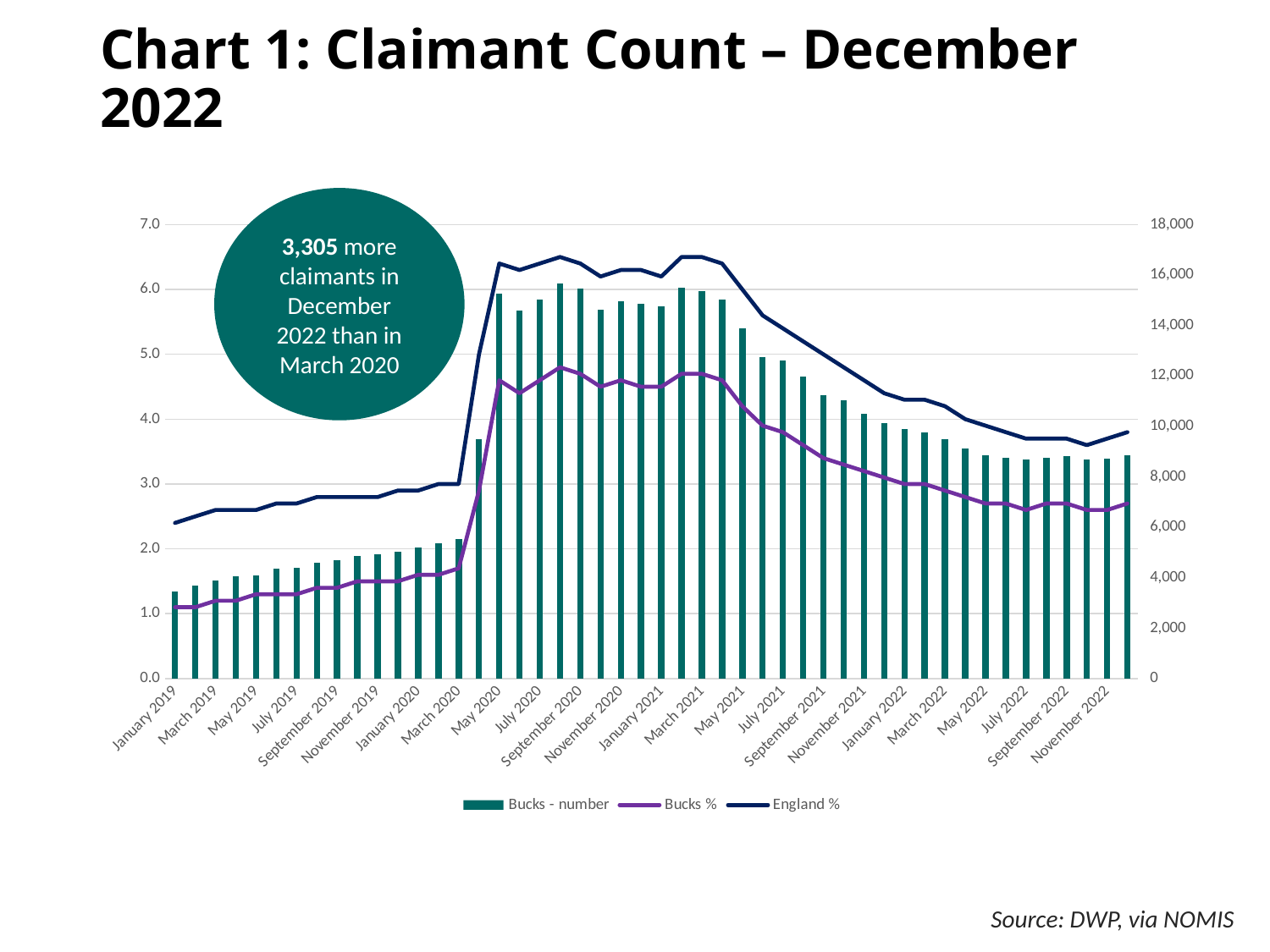
Is the Bucks - number value for September 2020 greater or less than 14,000? greater According to the callout, how many more claimants were there in December 2022 than in March 2020? 3,305 Which series is plotted as bars? Bucks - number Is the Bucks - number value for November 2022 greater or less than 10,000? less How many series does the legend list? 3 In September 2020, which is higher, the England % line or the Bucks % line? England % What kind of chart is shown on the slide? A combined bar and line chart Is the Bucks % value for March 2021 greater or less than 4.0? greater Do the Bucks - number bars rise or fall from May 2021 to November 2022? fall Which month has the lowest Bucks - number bar? January 2019